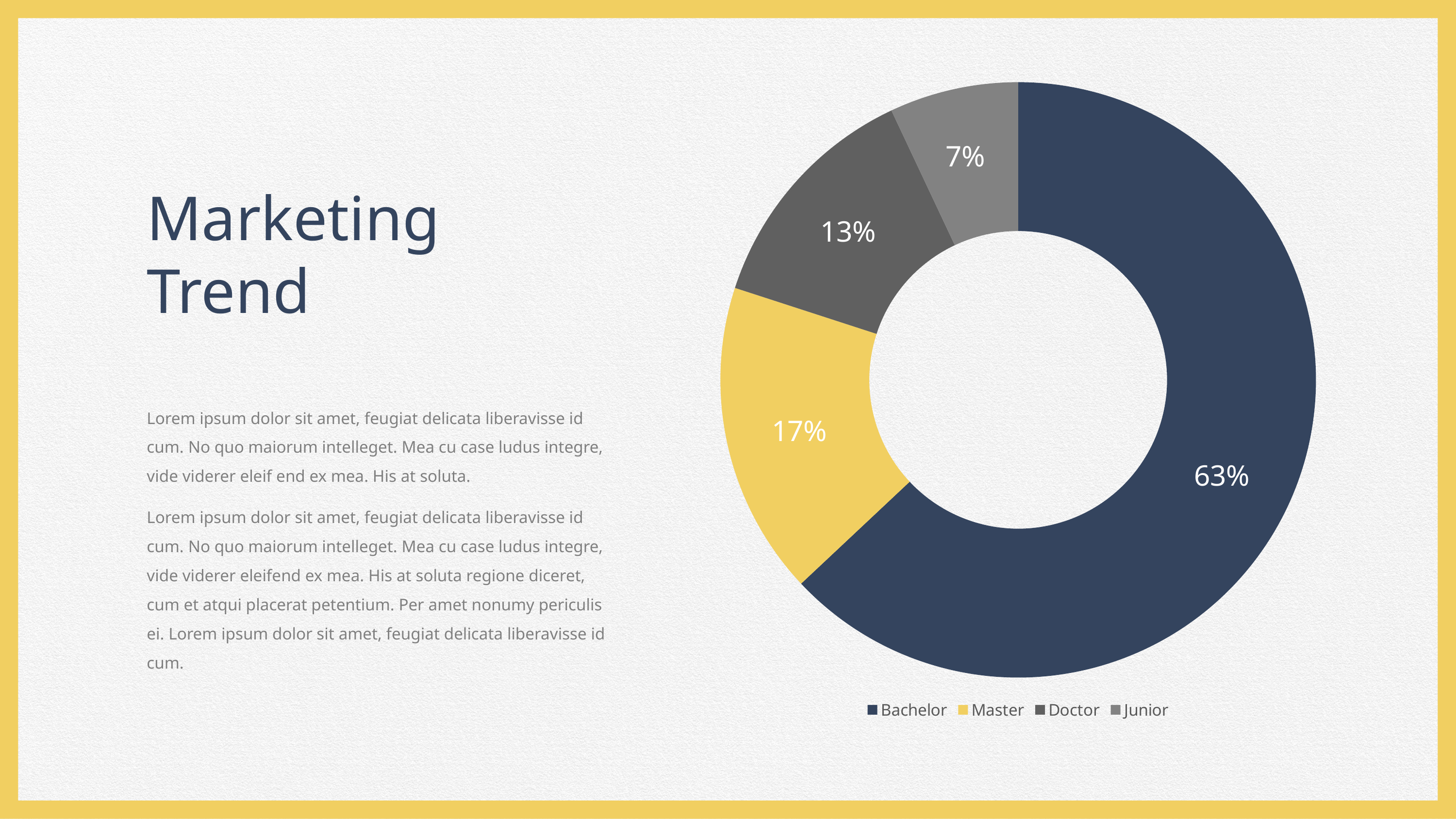
What type of chart is shown on the slide? Doughnut chart What is the value shown for Doctor? 13% What is the value shown for Junior? 7% Which category has the largest share? Bachelor What is the difference between the Doctor and Junior shares? 6% How many categories are shown in the chart? 4 Which category has the smallest share? Junior What share of the doughnut chart does Bachelor represent? 63% What is the difference between the Bachelor and Master shares? 46% What is the value shown for Master? 17% Which colour represents Master in the chart? Yellow Which is larger, the share for Master or the share for Doctor? Master